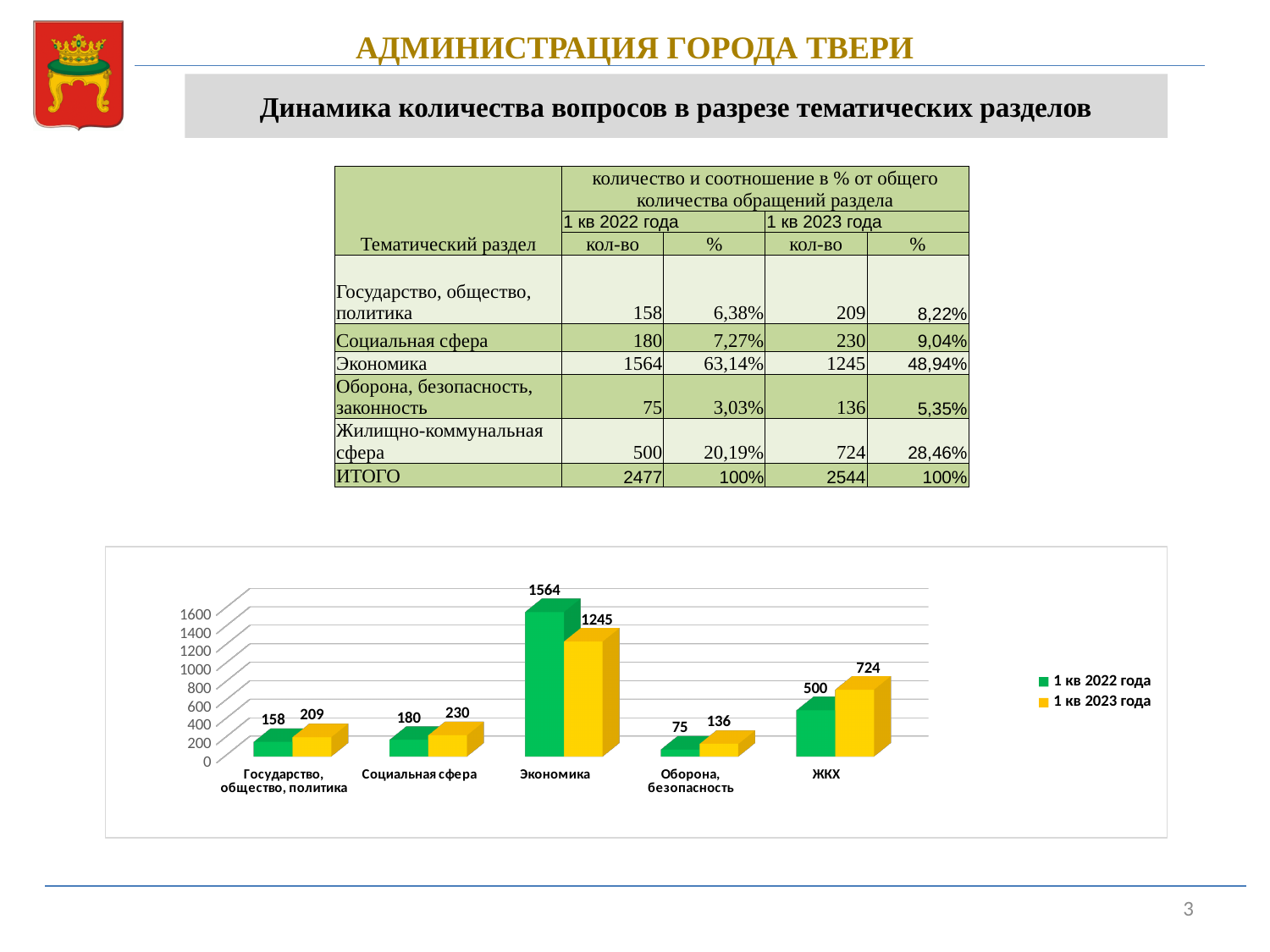
How many categories are shown on the x axis of the chart? 5 Which category has the lowest value in the 1 кв 2022 года series? Оборона, безопасность Which is larger for Социальная сфера: the 1 кв 2022 года value or the 1 кв 2023 года value? 1 кв 2023 года How many series does the chart legend list? 2 What is the difference between the 1 кв 2023 года and 1 кв 2022 года values for ЖКХ? 224 What is the value for Экономика in the 1 кв 2022 года series? 1564 What is the value for Оборона, безопасность in the 1 кв 2022 года series? 75 What is the difference between the 1 кв 2022 года and 1 кв 2023 года values for Экономика? 319 Which colour represents the 1 кв 2023 года series in the chart? Yellow What is the value for ЖКХ in the 1 кв 2023 года series? 724 What kind of chart is shown on the slide? Bar chart Which category has the highest value in the 1 кв 2023 года series? Экономика